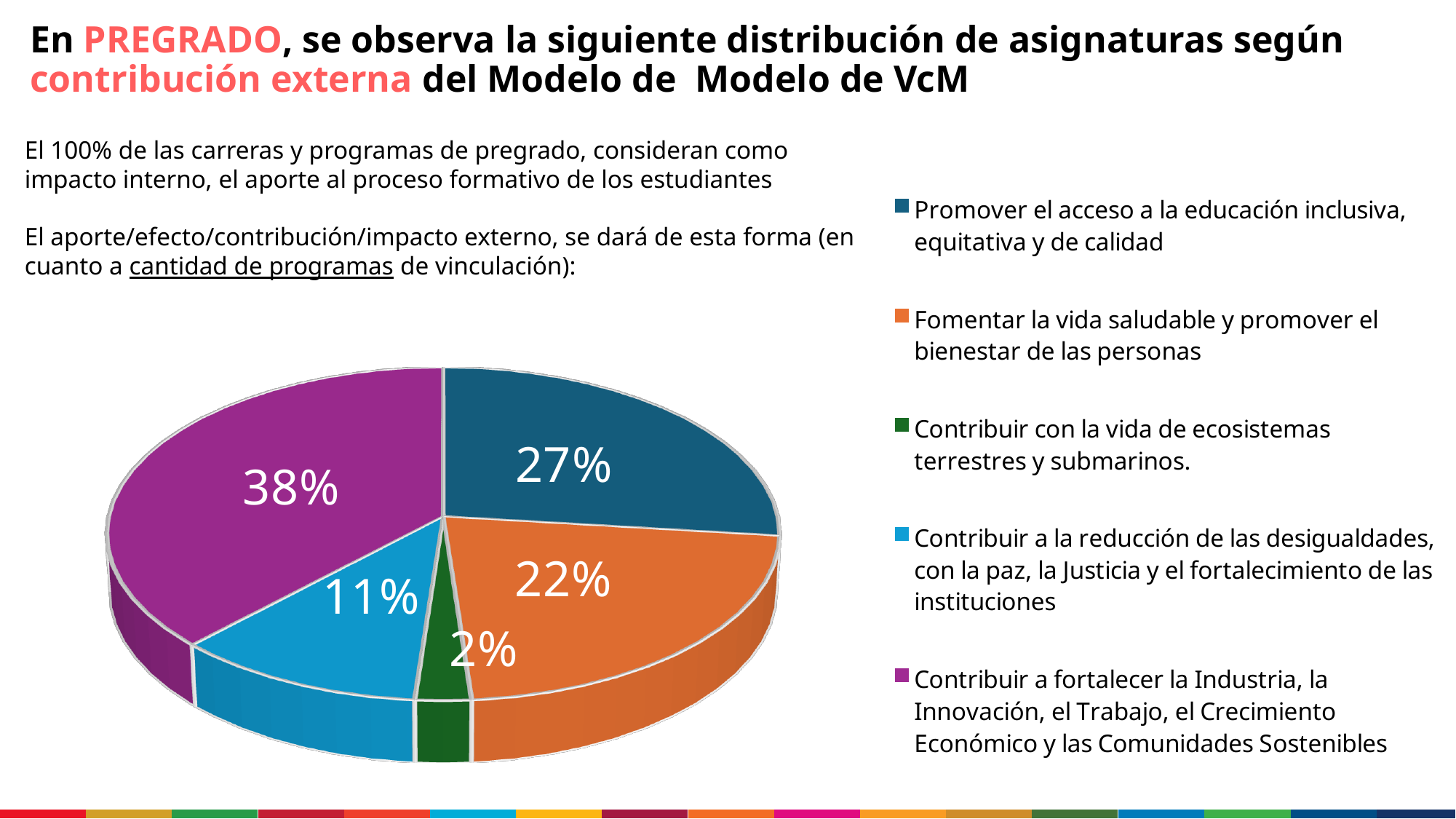
What colour is the slice for "Contribuir con la vida de ecosistemas terrestres y submarinos"? Green What share of the pie corresponds to "Contribuir a la reducción de las desigualdades, con la paz, la Justicia y el fortalecimiento de las instituciones"? 11% What kind of chart is shown on the slide? Pie chart What share of the pie corresponds to "Contribuir a fortalecer la Industria, la Innovación, el Trabajo, el Crecimiento Económico y las Comunidades Sostenibles"? 38% What share of the pie corresponds to "Fomentar la vida saludable y promover el bienestar de las personas"? 22% Which category has the largest slice of the pie? Contribuir a fortalecer la Industria, la Innovación, el Trabajo, el Crecimiento Económico y las Comunidades Sostenibles Which category has the smallest slice of the pie? Contribuir con la vida de ecosistemas terrestres y submarinos What is the difference in percentage points between the largest slice (38%) and the slice for "Promover el acceso a la educación inclusiva, equitativa y de calidad" (27%)? 11 percentage points How many categories does the pie chart have? 5 Which is larger: the slice for "Fomentar la vida saludable y promover el bienestar de las personas" or the slice for "Contribuir a la reducción de las desigualdades, con la paz, la Justicia y el fortalecimiento de las instituciones"? Fomentar la vida saludable y promover el bienestar de las personas